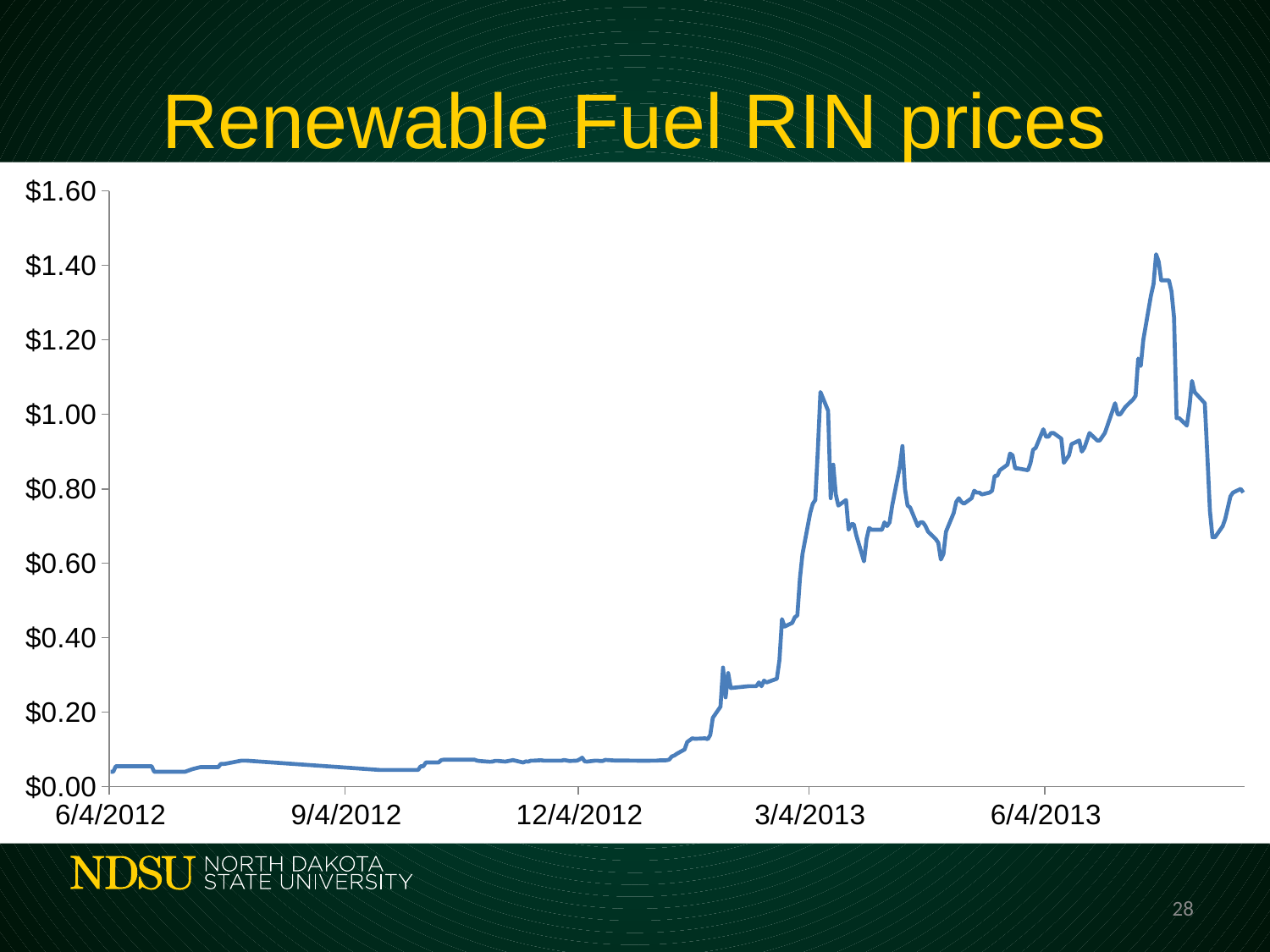
How many lines (series) are plotted on the chart? 1 What is the title of the chart? Renewable Fuel RIN prices What kind of chart is shown on the slide? line chart Is the peak value of the line greater or less than $1.20? greater Is the value at 3/4/2013 greater or less than $0.40? greater Which date has the larger value, 6/4/2012 or 6/4/2013? 6/4/2013 How many date labels are shown on the x axis? 5 Is the value at 6/4/2012 greater or less than $0.20? less What is the highest value shown on the y axis? $1.60 Overall, do RIN prices rise or fall from 6/4/2012 to 6/4/2013? rise